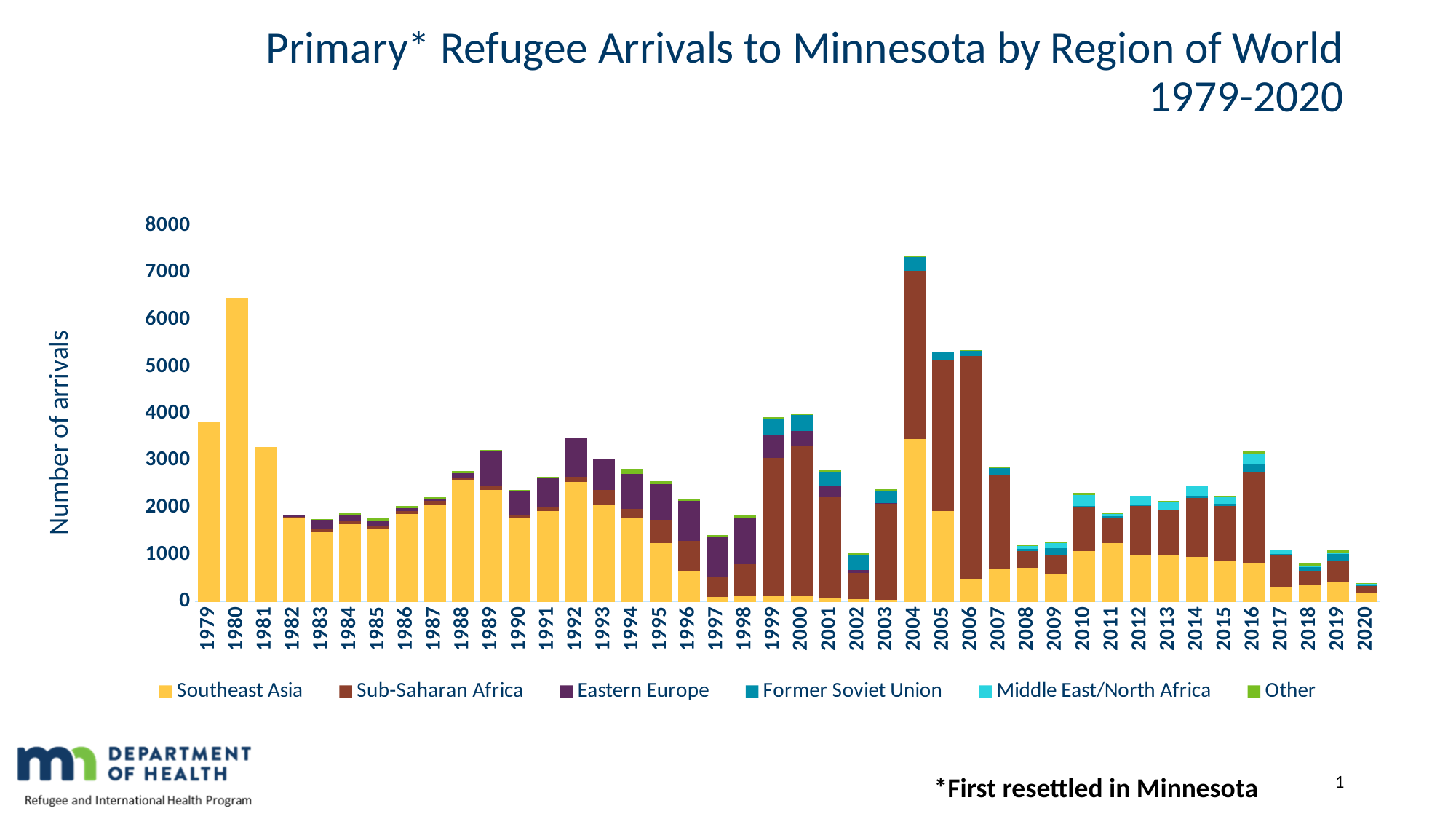
Which year has the highest total number of arrivals? 2004 How many years are shown along the x axis? 42 Is the total number of arrivals in 2005 greater or less than 5000? greater Is the total number of arrivals in 1980 greater or less than 6000? greater What kind of chart is shown on the slide? Stacked bar chart Do the total arrivals rise or fall from 2016 to 2020? fall How many series does the legend list? 6 Which year has a larger total number of arrivals, 1980 or 2004? 2004 Which year has a larger total number of arrivals, 1979 or 1981? 1979 Which year has the lowest total number of arrivals? 2020 Is the total number of arrivals in 2020 greater or less than 1000? less What is the label on the y axis? Number of arrivals